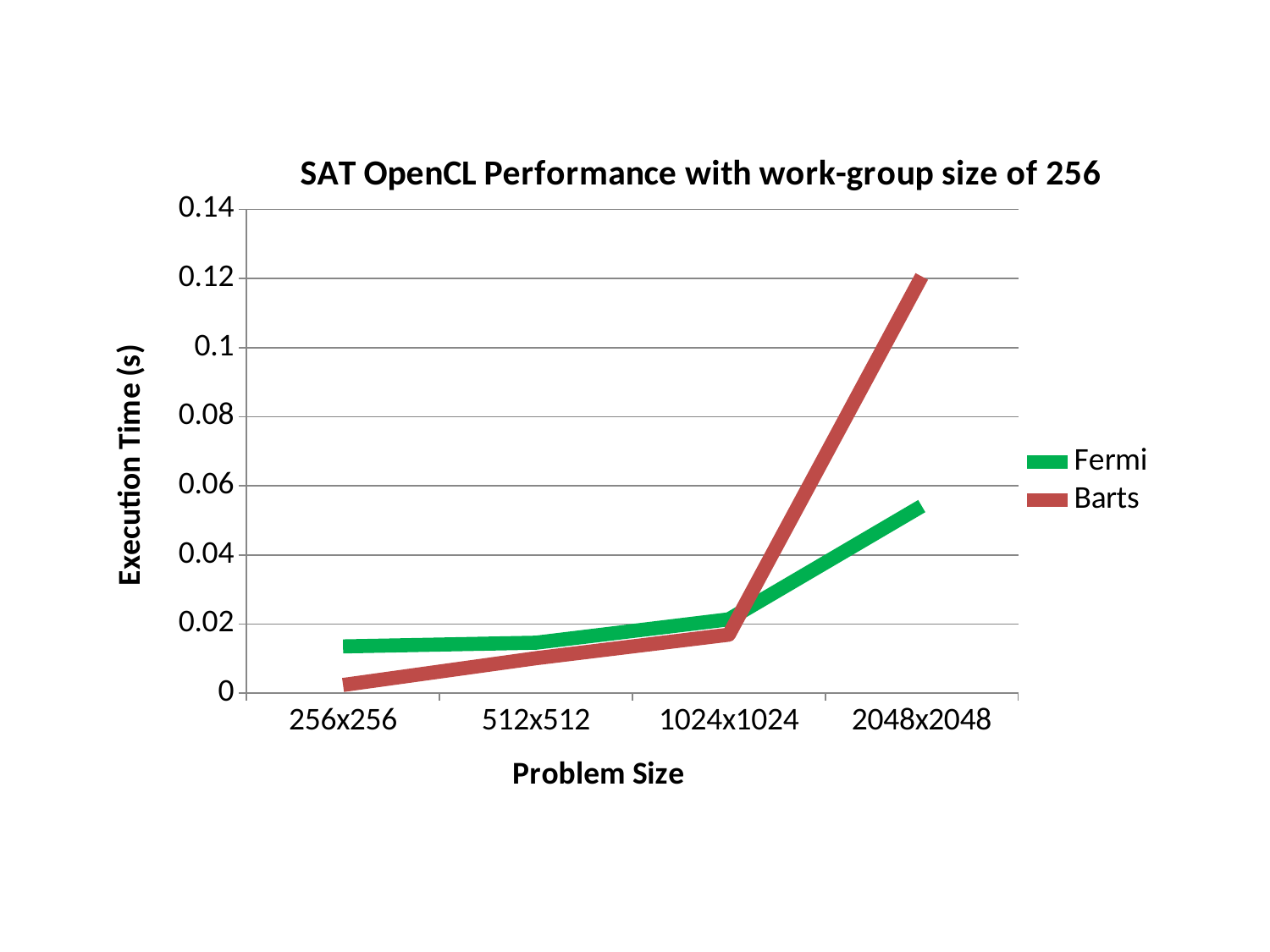
How many series does the legend list? 2 What is the title of the chart? SAT OpenCL Performance with work-group size of 256 What kind of chart is shown on the slide? line chart At which problem size is the execution time for Barts lowest? 256x256 Is the execution time for Fermi at 2048x2048 greater or less than 0.04? greater How many problem sizes are plotted along the x axis? 4 At which problem size is the execution time for Barts highest? 2048x2048 Does the execution time for Fermi rise or fall as the problem size increases? rise At 256x256, which series has the higher execution time, Fermi or Barts? Fermi Is the execution time for Fermi at 256x256 greater or less than 0.02? less At 2048x2048, which series has the higher execution time, Fermi or Barts? Barts Is the execution time for Barts at 2048x2048 greater or less than 0.1? greater